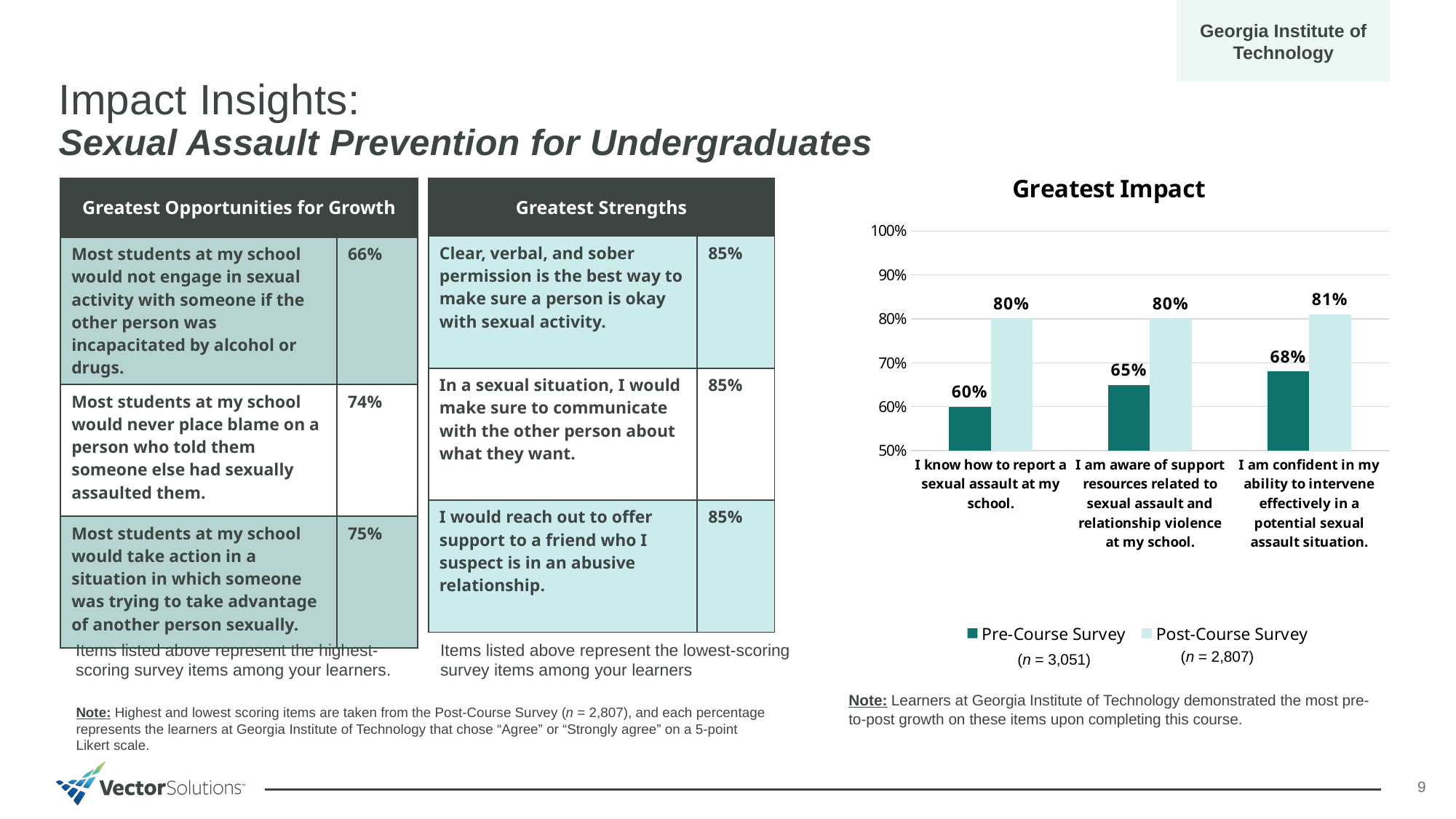
What is the Pre-Course Survey value for 'I am aware of support resources related to sexual assault and relationship violence at my school.'? 65% Which is larger for 'I am aware of support resources related to sexual assault and relationship violence at my school.': the Pre-Course Survey value or the Post-Course Survey value? Post-Course Survey How many categories are shown on the x axis of the 'Greatest Impact' chart? 3 Do the Pre-Course Survey values rise or fall from left to right across the categories? rise What is the difference between the Post-Course and Pre-Course Survey values for 'I know how to report a sexual assault at my school.'? 20% What is the Pre-Course Survey value for 'I know how to report a sexual assault at my school.'? 60% What is the Post-Course Survey value for 'I am confident in my ability to intervene effectively in a potential sexual assault situation.'? 81% Which category has the highest Pre-Course Survey value? I am confident in my ability to intervene effectively in a potential sexual assault situation. How many series does the legend of the 'Greatest Impact' chart list? 2 What type of chart is shown under the title 'Greatest Impact'? bar chart What is the title of the chart on the slide? Greatest Impact Which category has the lowest Pre-Course Survey value? I know how to report a sexual assault at my school.